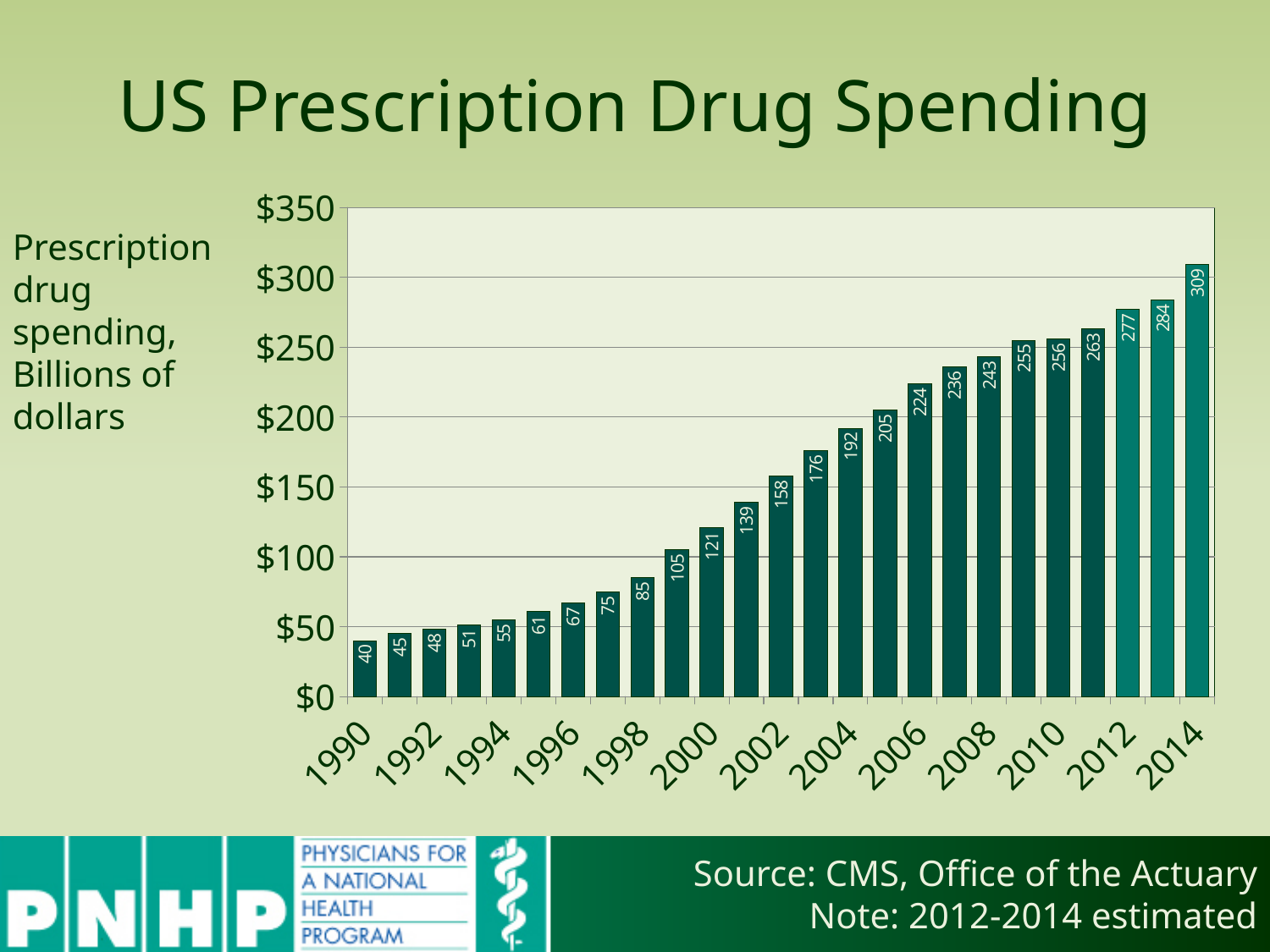
How many bars are shown in the chart? 25 What is the value for 2014? 309 What is the difference between the values for 2014 and 1990? 269 Which is larger, the value for 2004 or the value for 2006? 2006 What is the value for 2000? 121 What kind of chart is shown? Bar chart What is the value for 2008? 243 Which year has the lowest value? 1990 Which year has the highest value? 2014 What is the value for 1990? 40 What is the difference between the values for 2010 and 2000? 135 Do the values rise or fall from 1990 to 2014? Rise